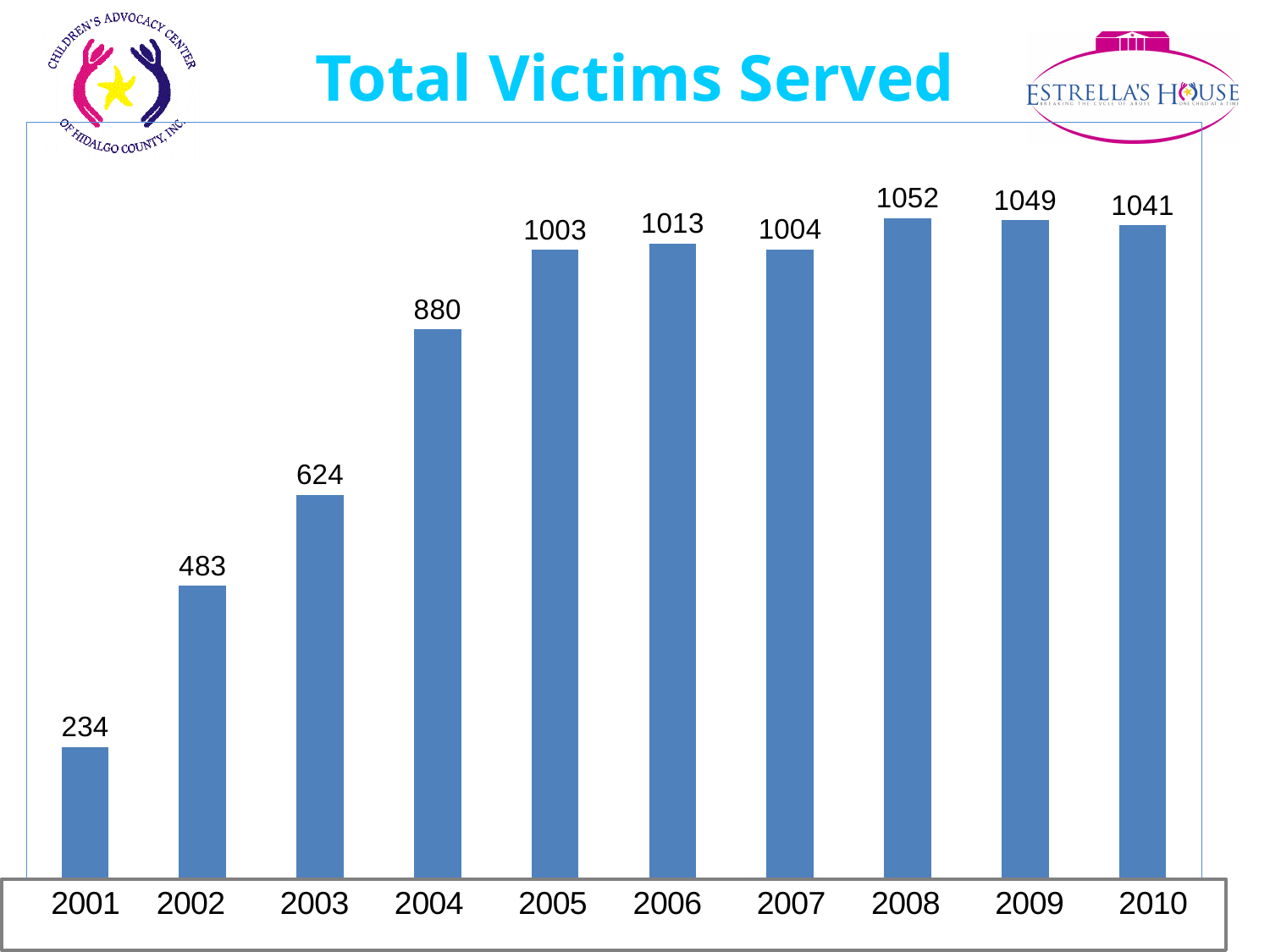
What is the title of the chart? Total Victims Served What is the difference between the values for 2002 and 2001? 249 Do the values rise or fall from 2001 to 2005? rise What kind of chart is this? bar chart What is the value for 2008? 1052 What is the value for 2001? 234 What is the difference between the values for 2008 and 2010? 11 How many years are shown on the x axis? 10 What is the value for 2004? 880 Which year has the highest value? 2008 Which is larger, the value for 2003 or the value for 2004? 2004 Which year has the lowest value? 2001